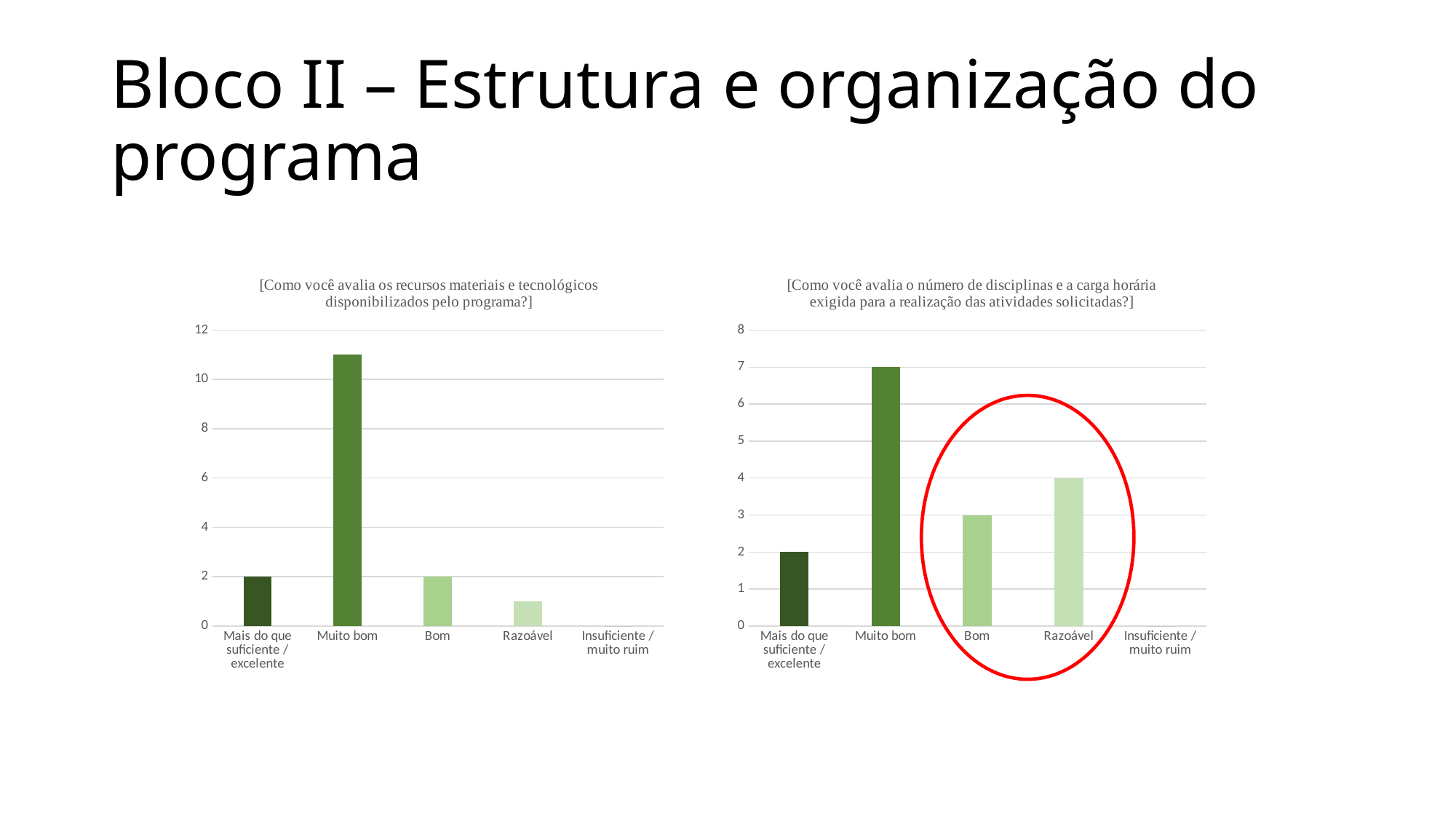
What kind of chart is the left chart (recursos materiais e tecnológicos)? Bar chart In the right chart (número de disciplinas e carga horária), what is the value for 'Muito bom'? 7 In the right chart (número de disciplinas e carga horária), what is the value for 'Razoável'? 4 In the right chart (número de disciplinas e carga horária), which is larger, 'Mais do que suficiente / excelente' or 'Bom'? Bom In the right chart (número de disciplinas e carga horária), what is the value for 'Bom'? 3 In the left chart (recursos materiais e tecnológicos), is the value for 'Razoável' greater or less than 2? less In the left chart (recursos materiais e tecnológicos), which category has the highest value? Muito bom In the left chart (recursos materiais e tecnológicos), what is the value for 'Bom'? 2 How many categories are shown on the x axis of the right chart (número de disciplinas e carga horária)? 5 In the right chart (número de disciplinas e carga horária), what is the difference between the values for 'Razoável' and 'Bom'? 1 In the left chart (recursos materiais e tecnológicos), is the value for 'Muito bom' greater or less than 10? greater In the right chart (número de disciplinas e carga horária), which two categories are highlighted with a red circle? Bom and Razoável